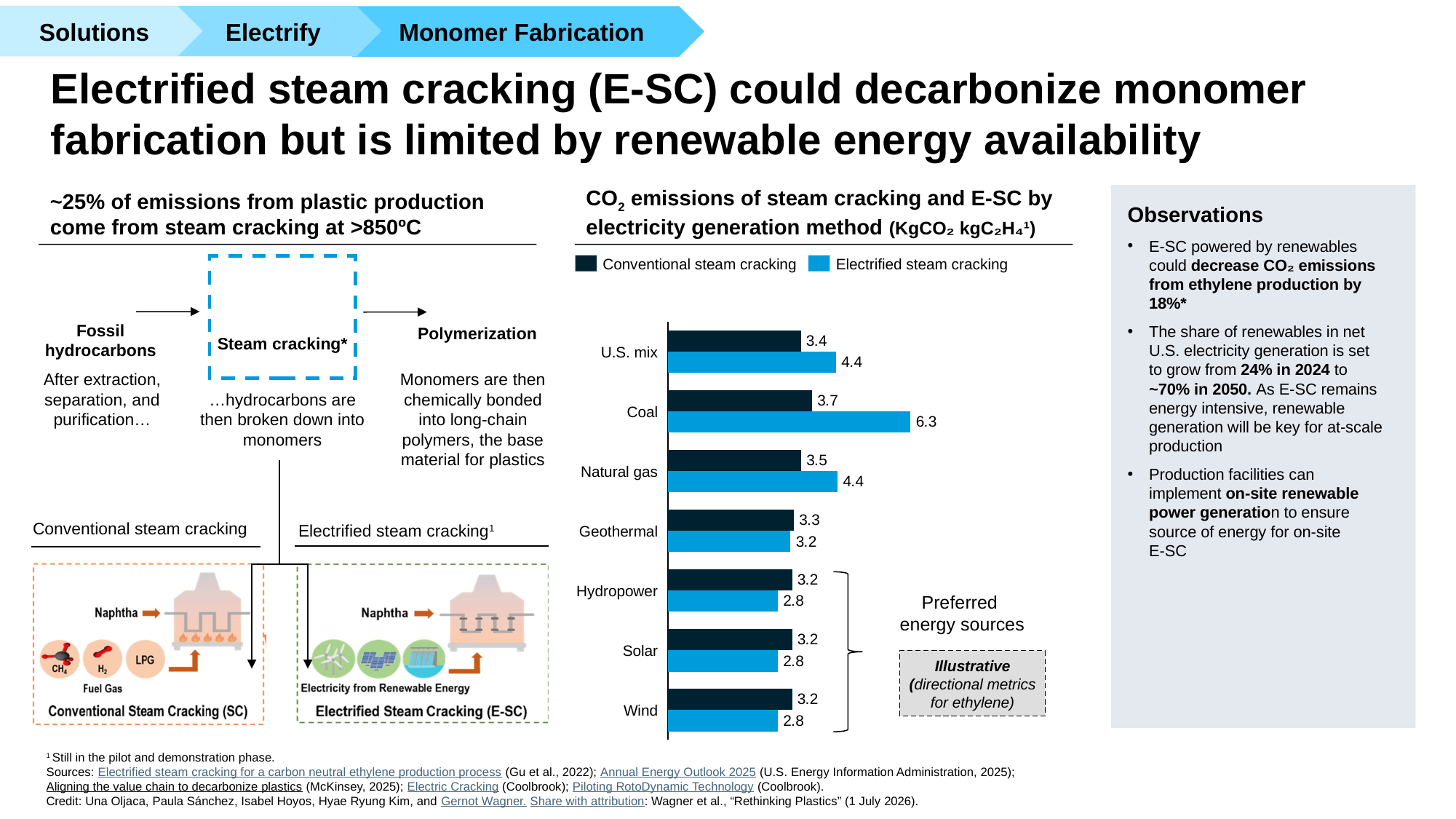
What is the conventional steam cracking value for the U.S. mix category? 3.4 What is the electrified steam cracking value for geothermal? 3.2 What is the difference between the electrified and conventional steam cracking values for coal? 2.6 Which electricity generation method has the highest electrified steam cracking value? Coal How many electricity generation methods are shown on the chart? 7 What type of chart is used to show CO2 emissions by electricity generation method? Bar chart What is the CO2 emissions value for electrified steam cracking with coal-generated electricity? 6.3 Which category has the highest conventional steam cracking value? Coal How many series does the chart legend list? 2 For natural gas, which is larger: the conventional or the electrified steam cracking value? Electrified steam cracking For solar, which is larger: the conventional or the electrified steam cracking value? Conventional steam cracking What is the difference between the conventional and electrified steam cracking values for wind? 0.4